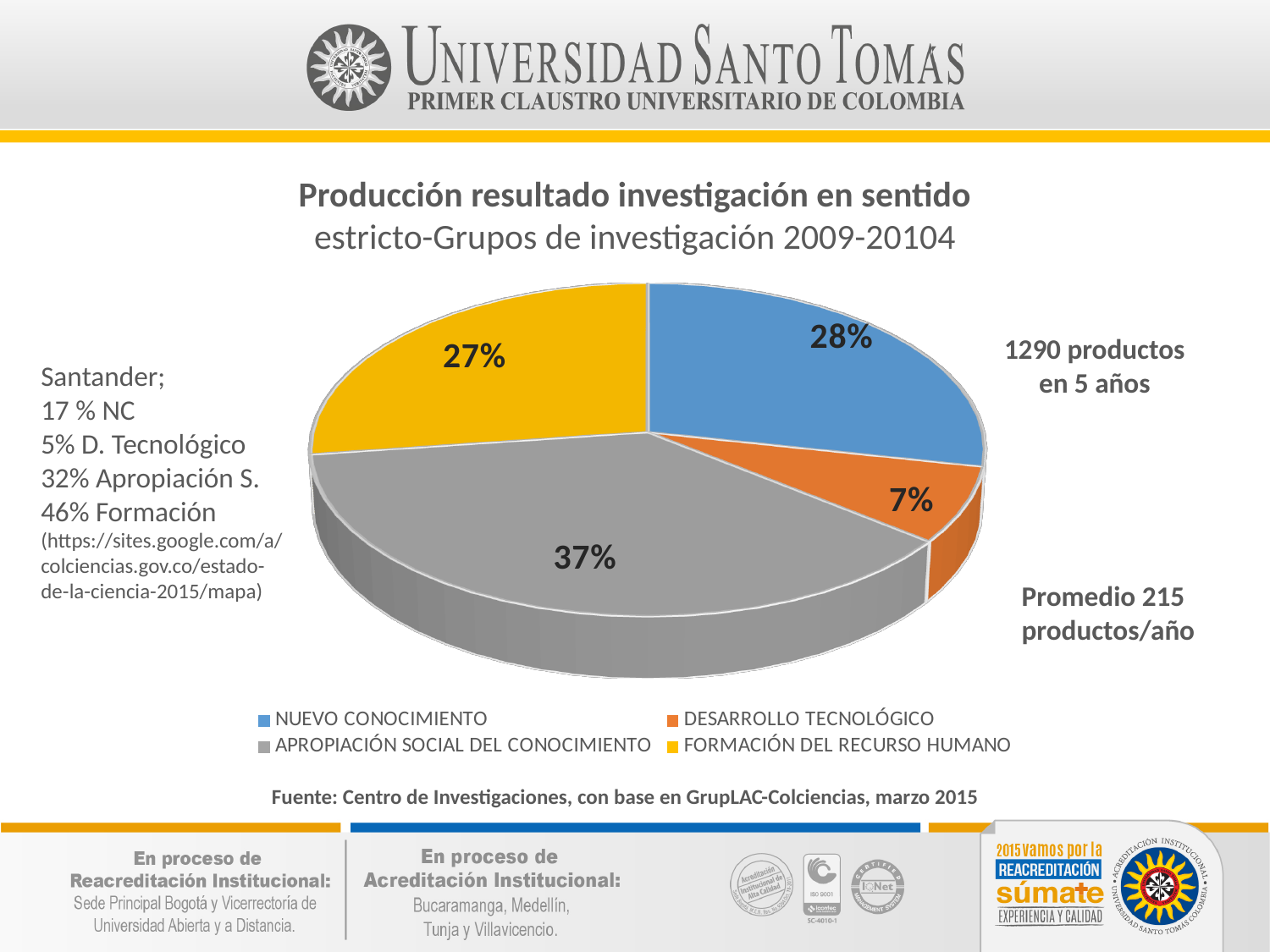
What is the difference in percentage points between APROPIACIÓN SOCIAL DEL CONOCIMIENTO and DESARROLLO TECNOLÓGICO? 30 percentage points What type of chart is shown on the slide? Pie chart What colour is the slice for DESARROLLO TECNOLÓGICO? Orange What share of the pie does NUEVO CONOCIMIENTO represent? 28% According to the text beside the chart, how many products were produced in 5 years? 1290 productos What share of the pie does DESARROLLO TECNOLÓGICO represent? 7% Which category has the smallest slice of the pie? DESARROLLO TECNOLÓGICO How many categories does the pie chart have? 4 What share of the pie does FORMACIÓN DEL RECURSO HUMANO represent? 27% Which is larger, the slice for NUEVO CONOCIMIENTO or the slice for FORMACIÓN DEL RECURSO HUMANO? NUEVO CONOCIMIENTO Which category has the largest slice of the pie? APROPIACIÓN SOCIAL DEL CONOCIMIENTO